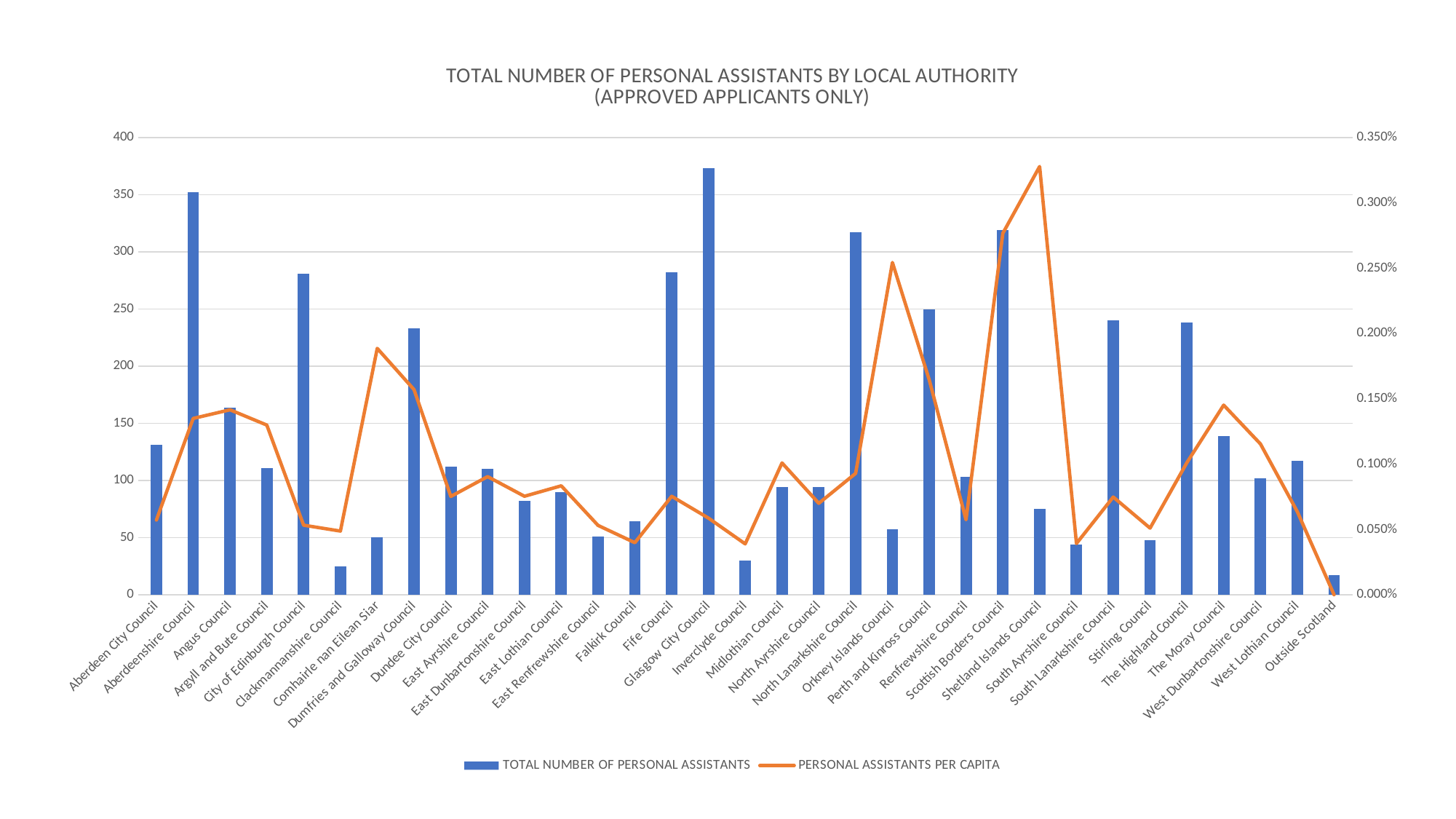
Which category has the lowest total number of personal assistants? Outside Scotland Is the total number of personal assistants for Clackmannanshire Council greater or less than 50? less Is the total number of personal assistants for Dumfries and Galloway Council greater or less than 200? greater Which local authority has the highest value for personal assistants per capita? Shetland Islands Council How many series does the legend list? 2 Which has a larger total number of personal assistants, Fife Council or North Lanarkshire Council? North Lanarkshire Council What colour is the line for personal assistants per capita? Orange Is the personal assistants per capita value for Shetland Islands Council greater or less than 0.300%? greater How many local authority categories are plotted along the x axis? 33 Which local authority has the highest total number of personal assistants? Glasgow City Council What kind of chart is shown on the slide? A combination bar and line chart